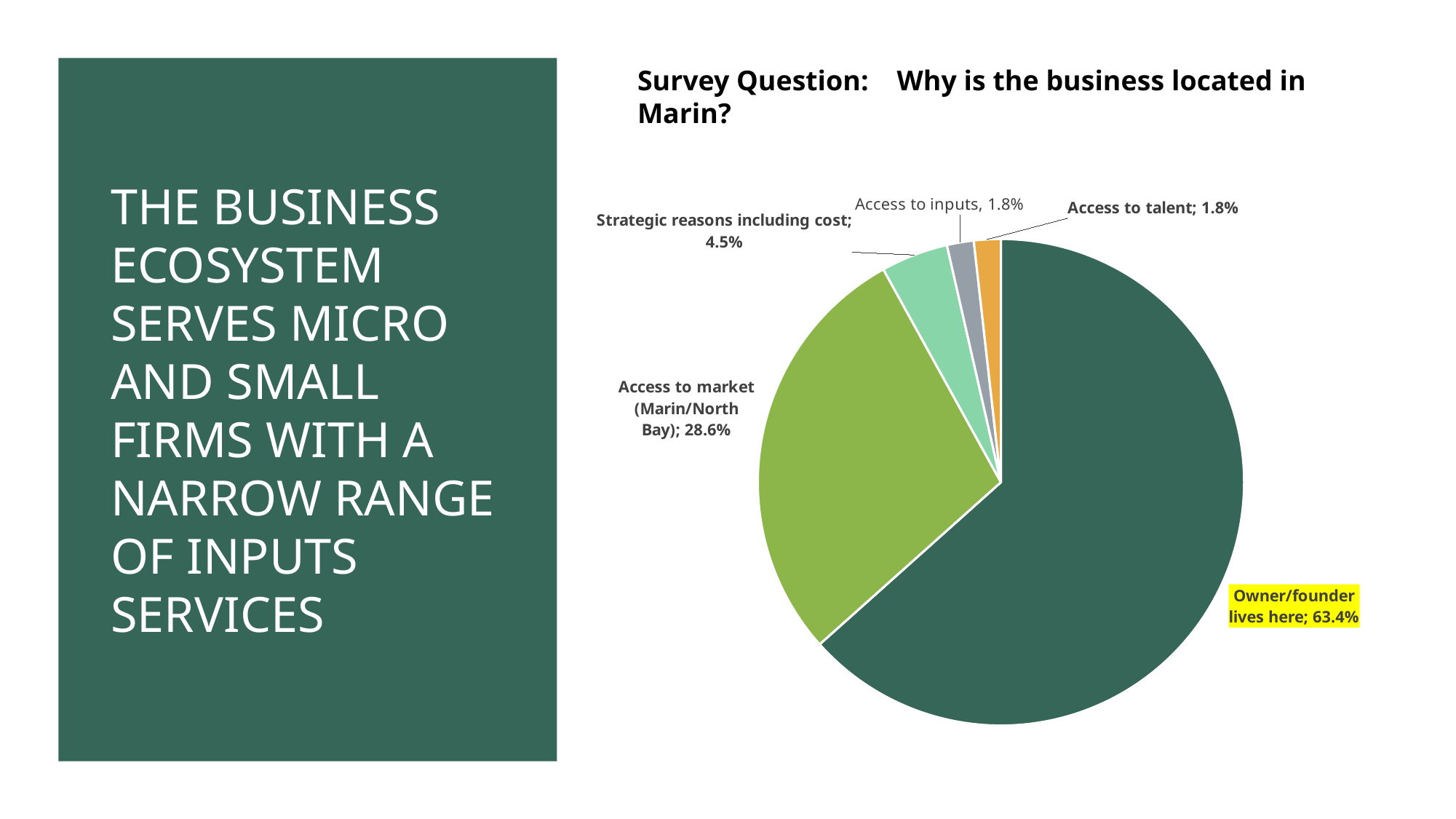
How many slices does the pie chart have? 5 What is the difference in percentage points between Owner/founder lives here and Access to market (Marin/North Bay)? 34.8 percentage points What percentage is shown for Access to market (Marin/North Bay)? 28.6% What survey question does the chart title say the pie chart answers? Why is the business located in Marin? What is the difference in percentage points between Strategic reasons including cost and Access to talent? 2.7 percentage points What share of respondents said the business is located in Marin because the owner/founder lives here? 63.4% What percentage is shown for Strategic reasons including cost? 4.5% What percentage is shown for Access to talent? 1.8% What kind of chart is shown on the slide? pie chart Which reason has the largest share of the pie? Owner/founder lives here What percentage is shown for Access to inputs? 1.8% Which is larger: the share for Access to market (Marin/North Bay) or the share for Strategic reasons including cost? Access to market (Marin/North Bay)